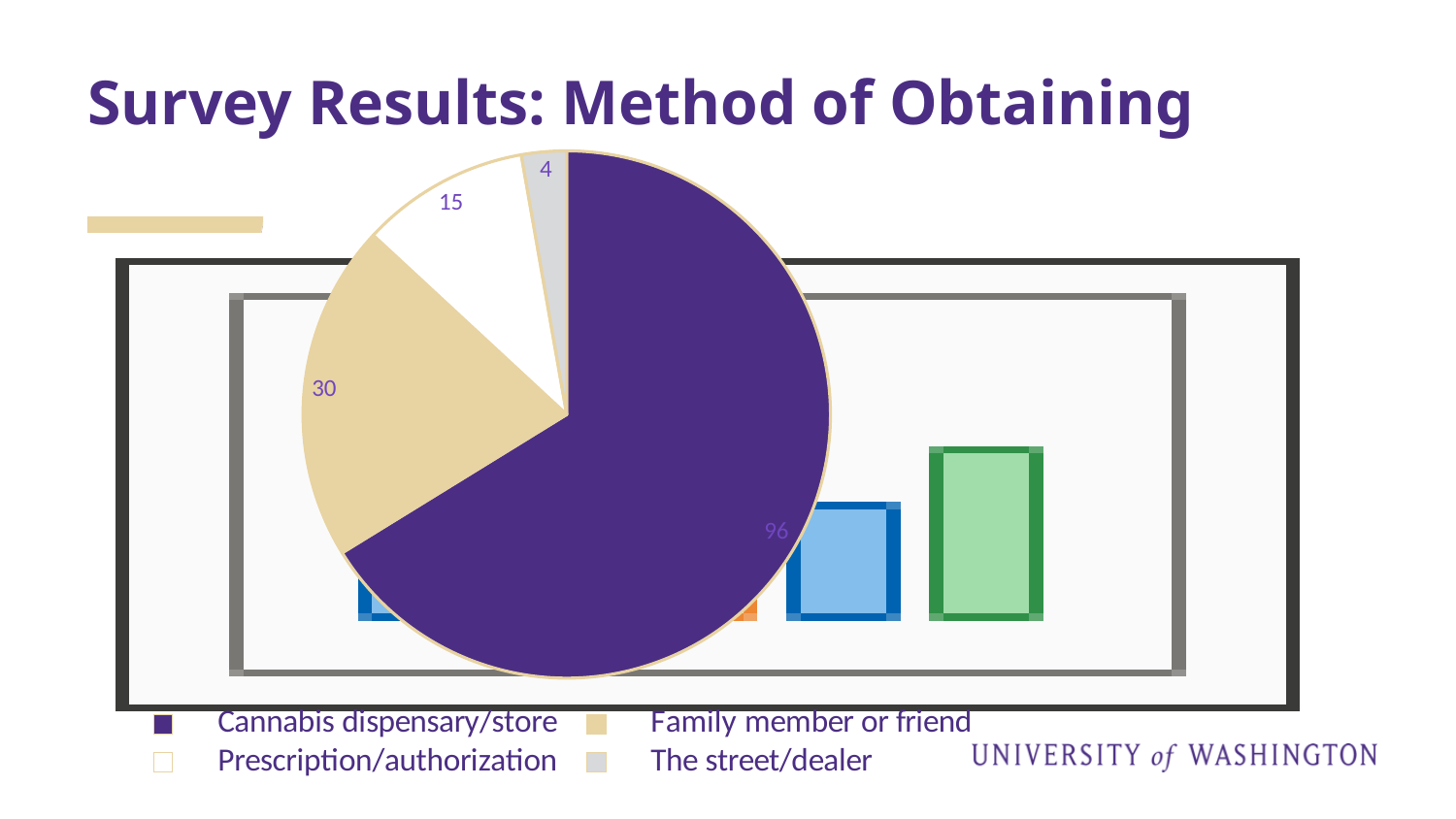
What is the value for Prescription/authorization? 15 How many categories does the pie chart have? 4 Which category has the largest slice of the pie? Cannabis dispensary/store What is the value for Family member or friend? 30 What type of chart is shown on the slide? pie chart What is the title of the slide containing the chart? Survey Results: Method of Obtaining What is the value for The street/dealer? 4 What is the value for Cannabis dispensary/store? 96 What is the total of all the values in the pie chart? 145 What is the difference between the values for Cannabis dispensary/store and Family member or friend? 66 Which is larger, the value for Family member or friend or the value for Prescription/authorization? Family member or friend Which category has the smallest slice of the pie? The street/dealer